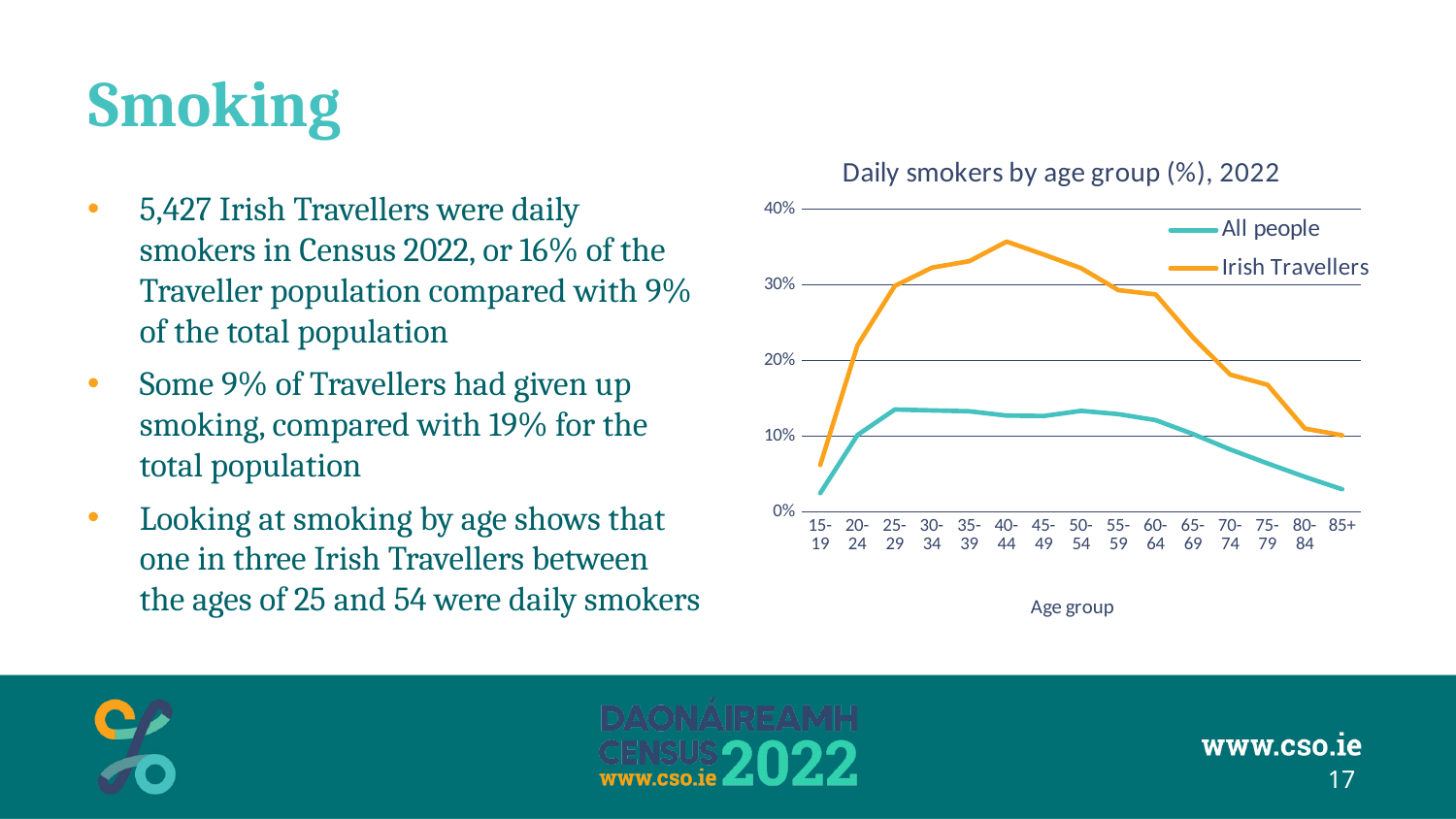
What kind of chart is shown on the slide? Line chart Is the value for Irish Travellers in the 15-19 age group greater or less than 10%? less What is the title of the chart? Daily smokers by age group (%), 2022 Is the value for Irish Travellers in the 40-44 age group greater or less than 30%? greater Which age group has the lowest value for Irish Travellers? 15-19 How many series does the chart's legend list? 2 Is the value for All people in the 85+ age group greater or less than 10%? less In the 40-44 age group, which series has the larger value, All people or Irish Travellers? Irish Travellers How many age groups are plotted along the x axis? 15 Do the values for Irish Travellers rise or fall from the 40-44 age group to the 85+ age group? Fall Which age group has the highest value for Irish Travellers? 40-44 Which age group has the lowest value for All people? 15-19